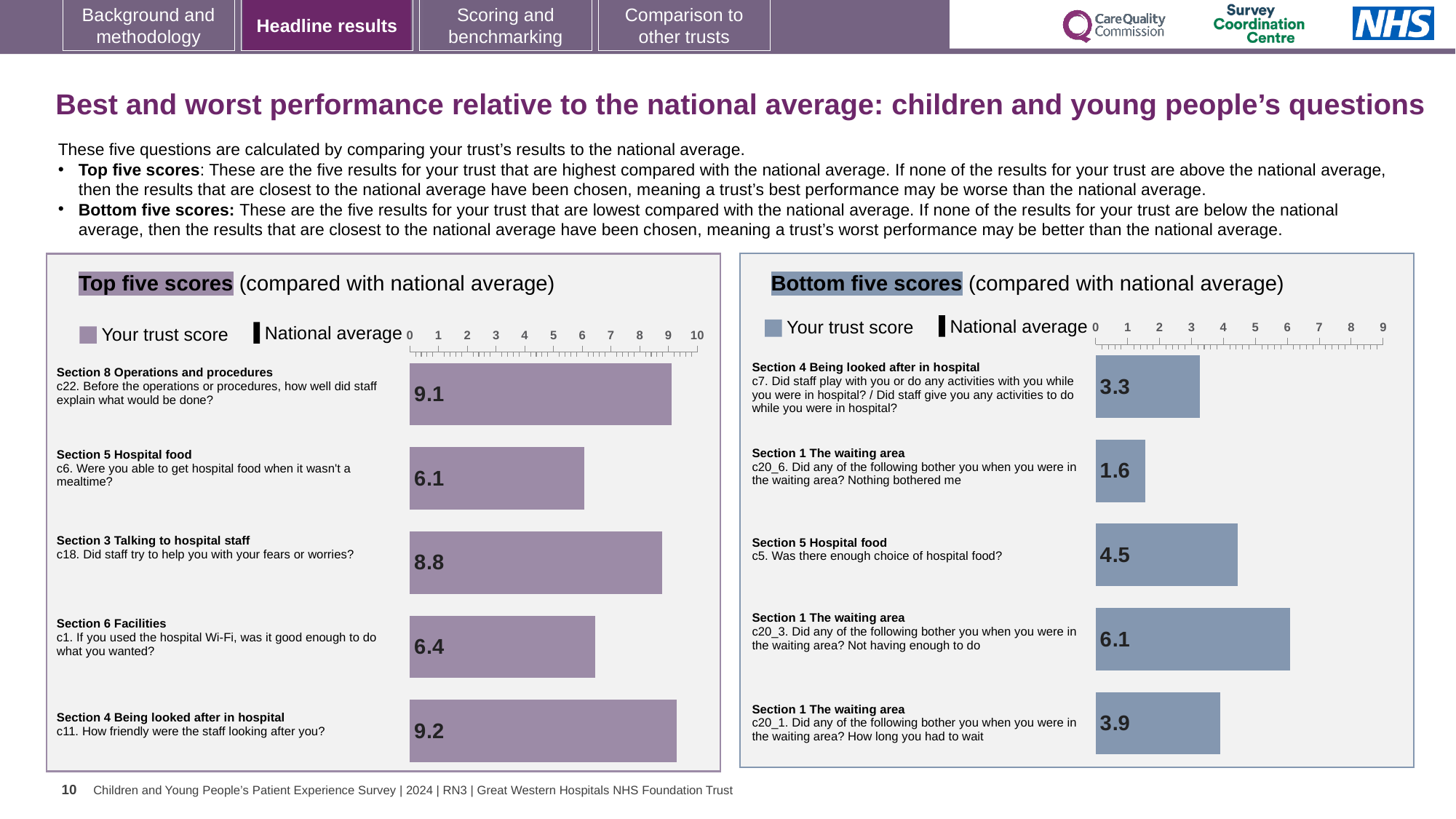
In the Bottom five scores chart, which question has the lowest trust score? c20_6. Nothing bothered me In the Top five scores chart, which question has the lowest trust score? c6. Were you able to get hospital food when it wasn't a mealtime? How many questions are plotted in the Bottom five scores chart? 5 In the Bottom five scores chart, which has the larger trust score: c7 or c20_1? c20_1 What type of chart is the Top five scores chart? Bar chart In the Top five scores chart, what is the difference between the trust scores for c18 and c6? 2.7 In the Top five scores chart, which question has the highest trust score? c11. How friendly were the staff looking after you? In the Bottom five scores chart, which question has the highest trust score? c20_3. Not having enough to do In the Bottom five scores chart, what is the trust score for c20_1 (How long you had to wait)? 3.9 In the Bottom five scores chart, what is the trust score for c5 (Was there enough choice of hospital food)? 4.5 In the Top five scores chart, what is the trust score for c1 (If you used the hospital Wi-Fi, was it good enough to do what you wanted)? 6.4 In the Top five scores chart, what is the trust score for c22 (Before the operations or procedures, how well did staff explain what would be done)? 9.1